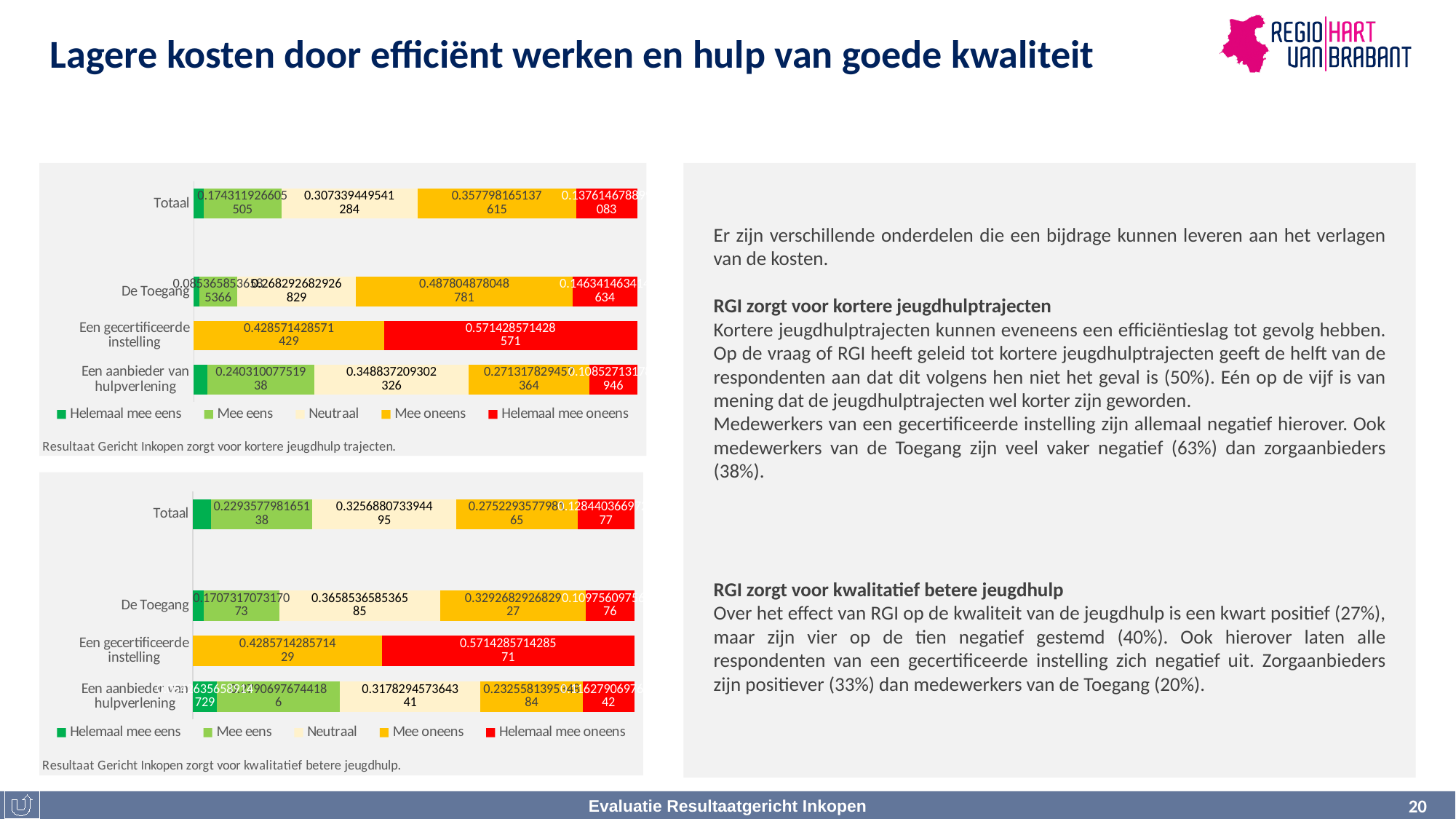
How many series does the legend of the bottom chart, 'Resultaat Gericht Inkopen zorgt voor kwalitatief betere jeugdhulp', list? 5 In the bottom chart, 'Resultaat Gericht Inkopen zorgt voor kwalitatief betere jeugdhulp', what is the 'Mee eens' value for 'De Toegang'? 0.170731707317073 How many categories are shown on the y axis of the top chart, 'Resultaat Gericht Inkopen zorgt voor kortere jeugdhulp trajecten'? 4 In the top chart, 'Resultaat Gericht Inkopen zorgt voor kortere jeugdhulp trajecten', what is the 'Helemaal mee oneens' value for 'Een gecertificeerde instelling'? 0.571428571428571 In the top chart, 'Resultaat Gericht Inkopen zorgt voor kortere jeugdhulp trajecten', which series has the largest share for 'De Toegang'? Mee oneens In the bottom chart, 'Resultaat Gericht Inkopen zorgt voor kwalitatief betere jeugdhulp', which is larger for 'Totaal': the 'Neutraal' value or the 'Mee oneens' value? Neutraal In the top chart, 'Resultaat Gericht Inkopen zorgt voor kortere jeugdhulp trajecten', which series has the largest share for 'Een gecertificeerde instelling'? Helemaal mee oneens In the top chart, 'Resultaat Gericht Inkopen zorgt voor kortere jeugdhulp trajecten', what is the 'Mee oneens' value for 'Een gecertificeerde instelling'? 0.428571428571429 In the bottom chart, 'Resultaat Gericht Inkopen zorgt voor kwalitatief betere jeugdhulp', what is the 'Neutraal' value for 'Een aanbieder van hulpverlening'? 0.317829457364341 Which colour represents 'Helemaal mee oneens' in the legend of the bottom chart, 'Resultaat Gericht Inkopen zorgt voor kwalitatief betere jeugdhulp'? Red What kind of chart is the top chart, 'Resultaat Gericht Inkopen zorgt voor kortere jeugdhulp trajecten'? Stacked bar chart In the bottom chart, 'Resultaat Gericht Inkopen zorgt voor kwalitatief betere jeugdhulp', what is the 'Neutraal' value for 'Totaal'? 0.325688073394495